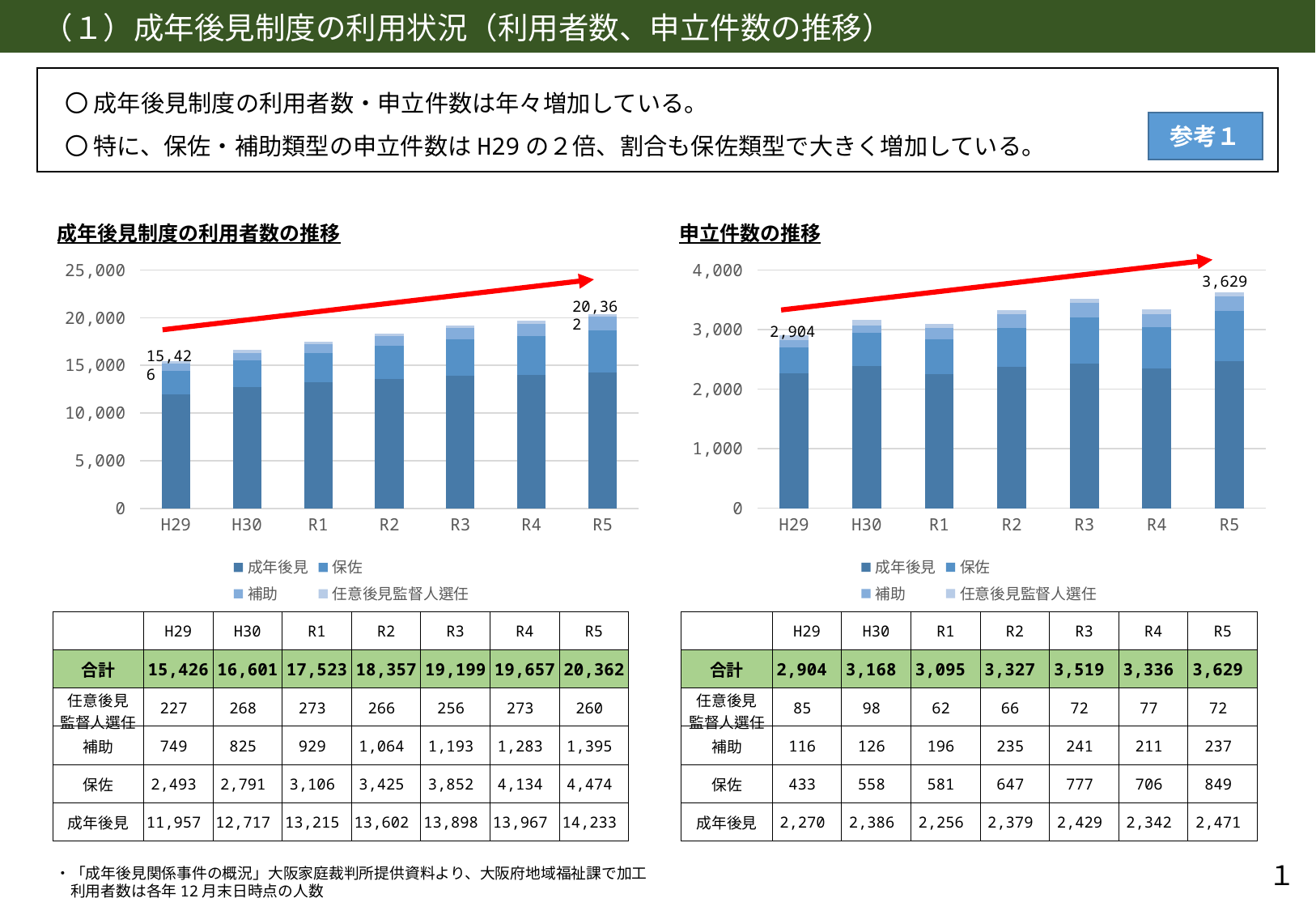
In the chart titled 成年後見制度の利用者数の推移, what is the total value labelled for R5? 20,362 In the chart titled 申立件数の推移, what is the total value labelled for H29? 2,904 What kind of chart is the chart titled 申立件数の推移? Stacked bar chart In the chart titled 成年後見制度の利用者数の推移, is the total for R2 greater or less than 15,000? greater In the chart titled 成年後見制度の利用者数の推移, what is the difference between the R5 total and the H29 total? 4,936 In the chart titled 成年後見制度の利用者数の推移, do the totals rise or fall from H29 to R5? Rise In the chart titled 申立件数の推移, which year has the lowest total? H29 In the chart titled 申立件数の推移, which is larger, the total for R3 or the total for R4? R3 In the chart titled 申立件数の推移, what is the value of the 成年後見 series for R5 according to the table? 2,471 How many years are shown on the x axis of the chart titled 申立件数の推移? 7 In the chart titled 申立件数の推移, which year has the highest total? R5 How many series does the legend of the chart titled 成年後見制度の利用者数の推移 list? 4